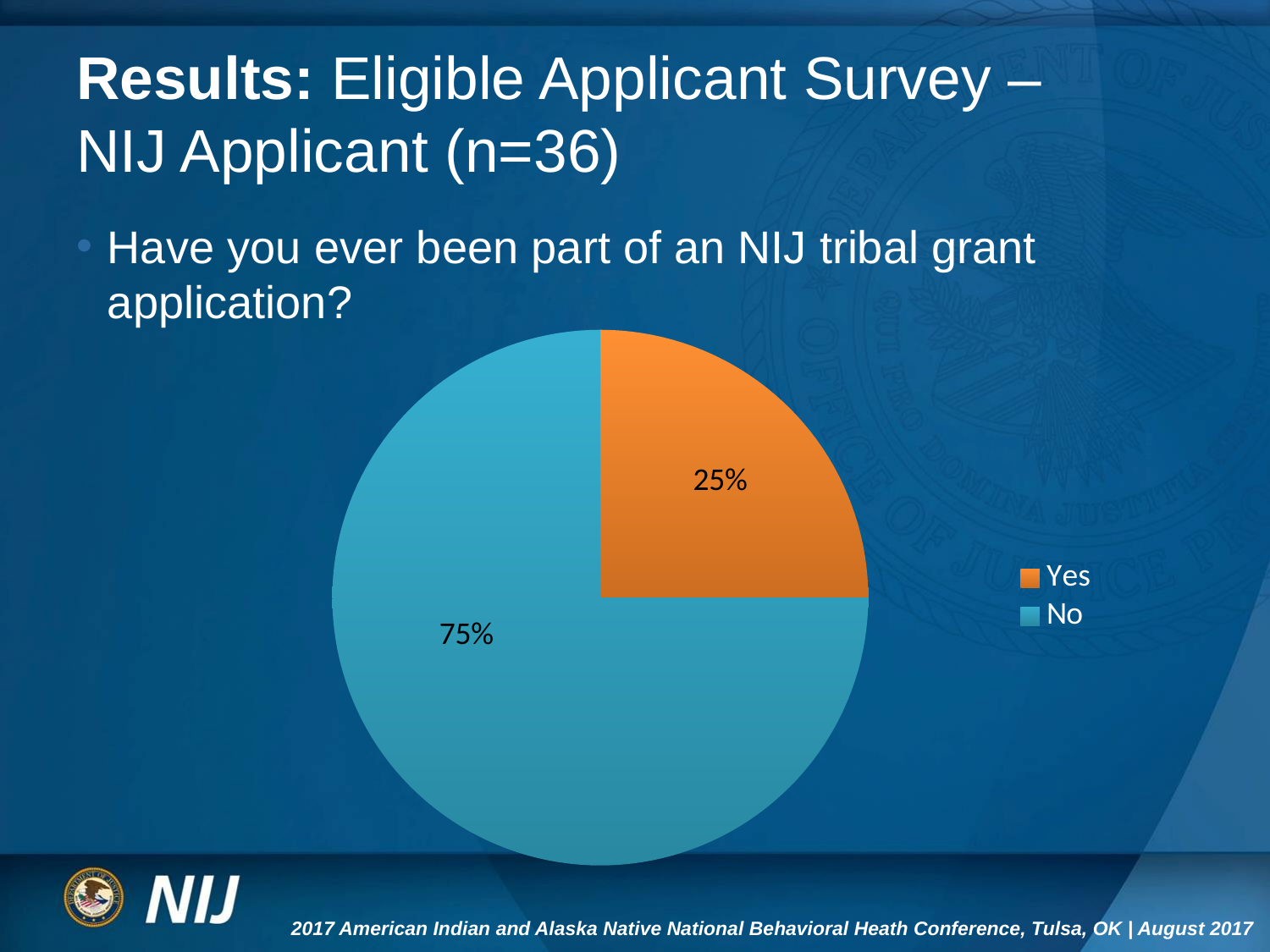
Which response has the largest share of the pie? No What percentage of respondents answered "No"? 75% Which response has the smallest share of the pie? Yes What percentage of respondents answered "Yes"? 25% Which slice is larger, "Yes" or "No"? No What colour is the "No" slice? blue What colour is the "Yes" slice? orange What is the difference in percentage points between the "No" and "Yes" slices? 50 How many slices does the pie chart have? 2 What kind of chart is shown on the slide? pie chart How many entries does the legend list? 2 What share of the pie does the "No" slice represent? 75%